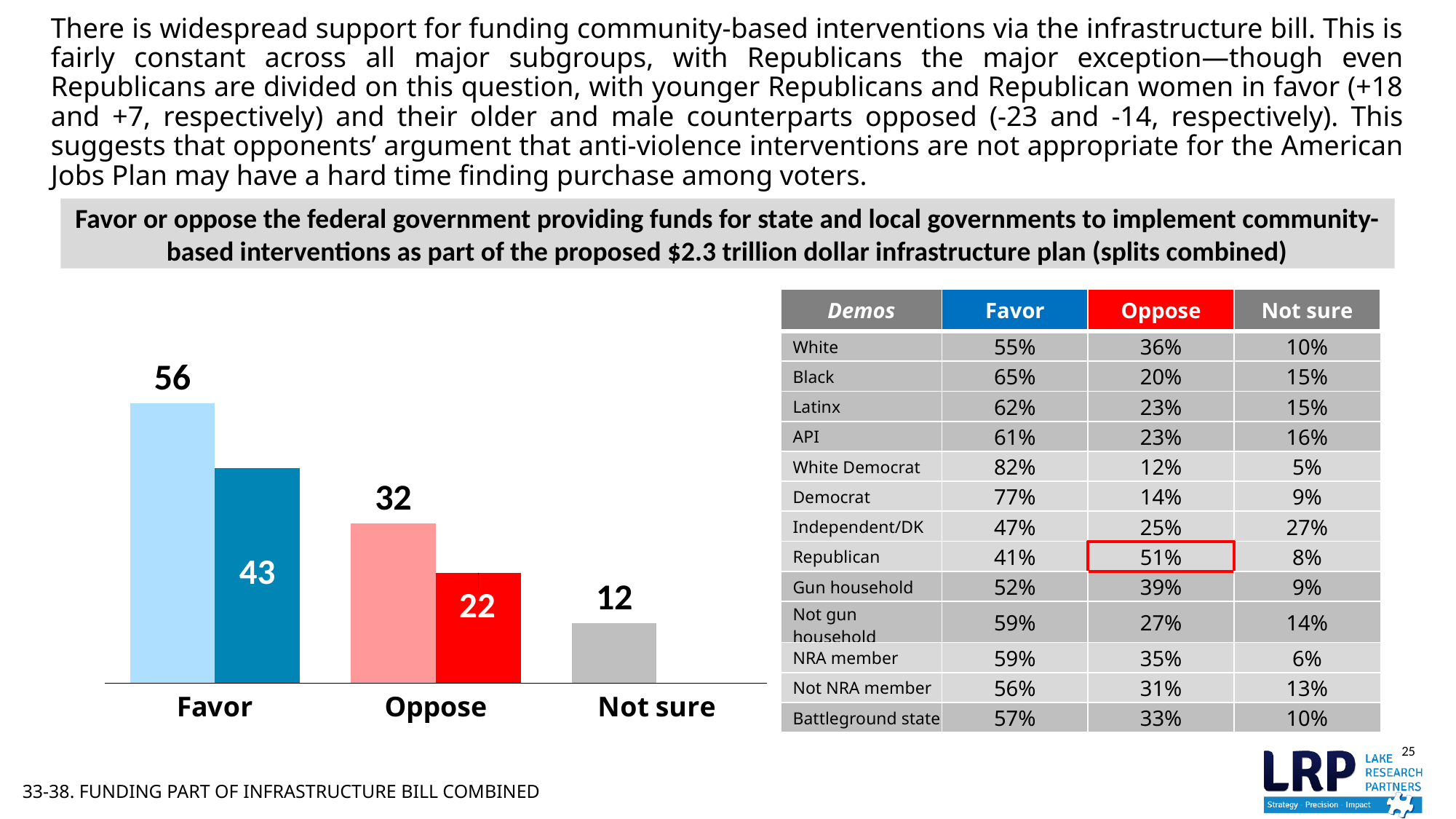
What kind of chart is shown on the slide? Bar chart Which category has the lowest value? Not sure What value is printed inside the darker blue bar in the Favor group? 43 What is the difference between the Oppose value (32) and the Not sure value (12)? 20 What is the value shown above the Favor bar? 56 What is the value shown above the Oppose bar? 32 What is the value for Not sure? 12 Which is larger, the value for Favor or the value for Oppose? Favor How many categories are shown on the x axis of the chart? 3 What is the difference between the Favor value (56) and the Oppose value (32)? 24 Which category has the highest value? Favor What value is printed inside the bright red bar in the Oppose group? 22